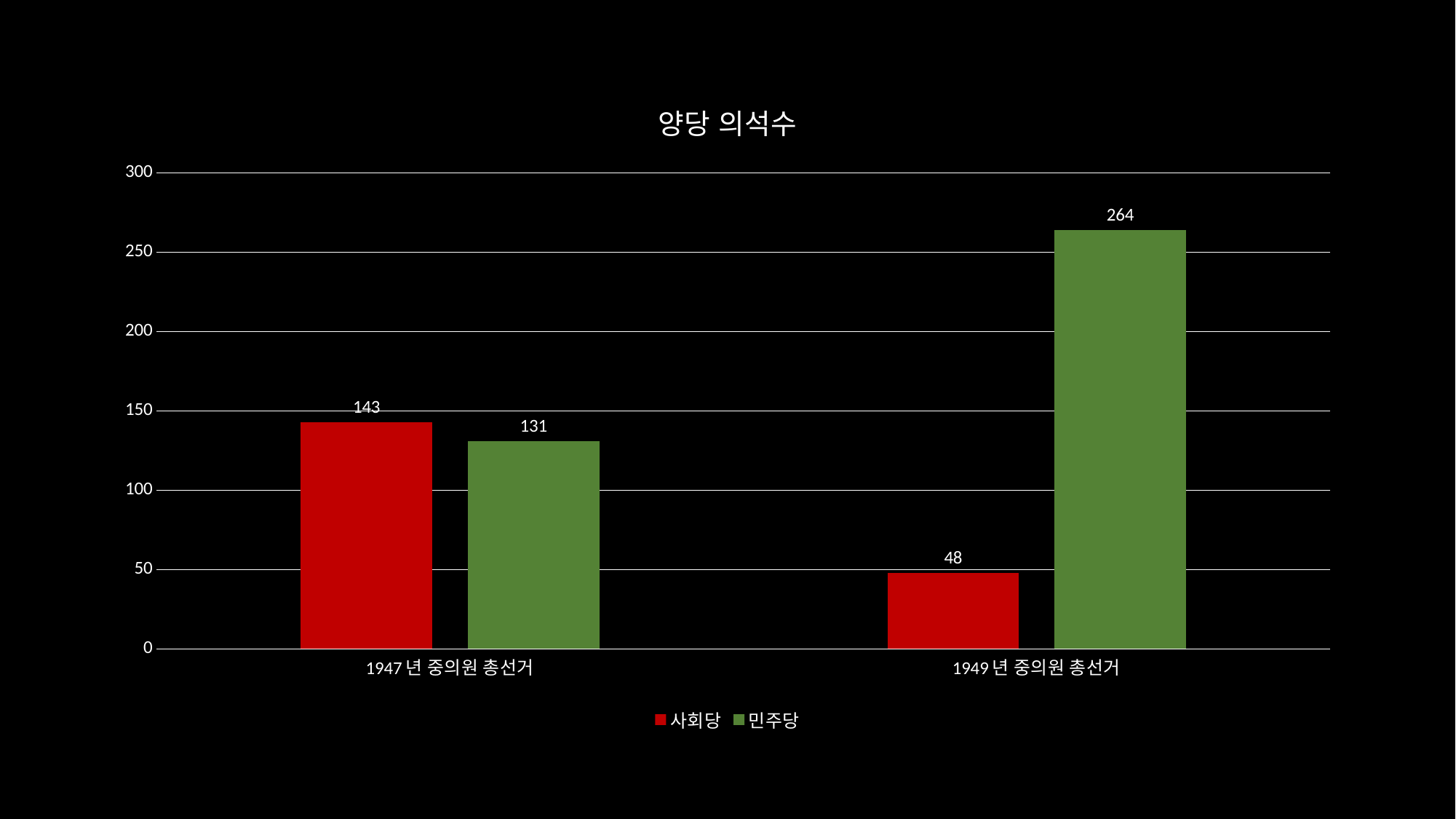
What is the value for 민주당 in 1947 년 중의원 총선거? 131 Which is larger in 1947 년 중의원 총선거, 사회당 or 민주당? 사회당 What kind of chart is shown on the slide? bar chart Which bar has the lowest value in the chart? 사회당 in 1949 년 중의원 총선거 Which bar has the highest value in the chart? 민주당 in 1949 년 중의원 총선거 What is the difference between 민주당 and 사회당 in 1949 년 중의원 총선거? 216 What is the value for 민주당 in 1949 년 중의원 총선거? 264 What is the title of the chart? 양당 의석수 What is the value for 사회당 in 1947 년 중의원 총선거? 143 How many categories are shown on the x axis? 2 What is the value for 사회당 in 1949 년 중의원 총선거? 48 How many series does the legend list? 2